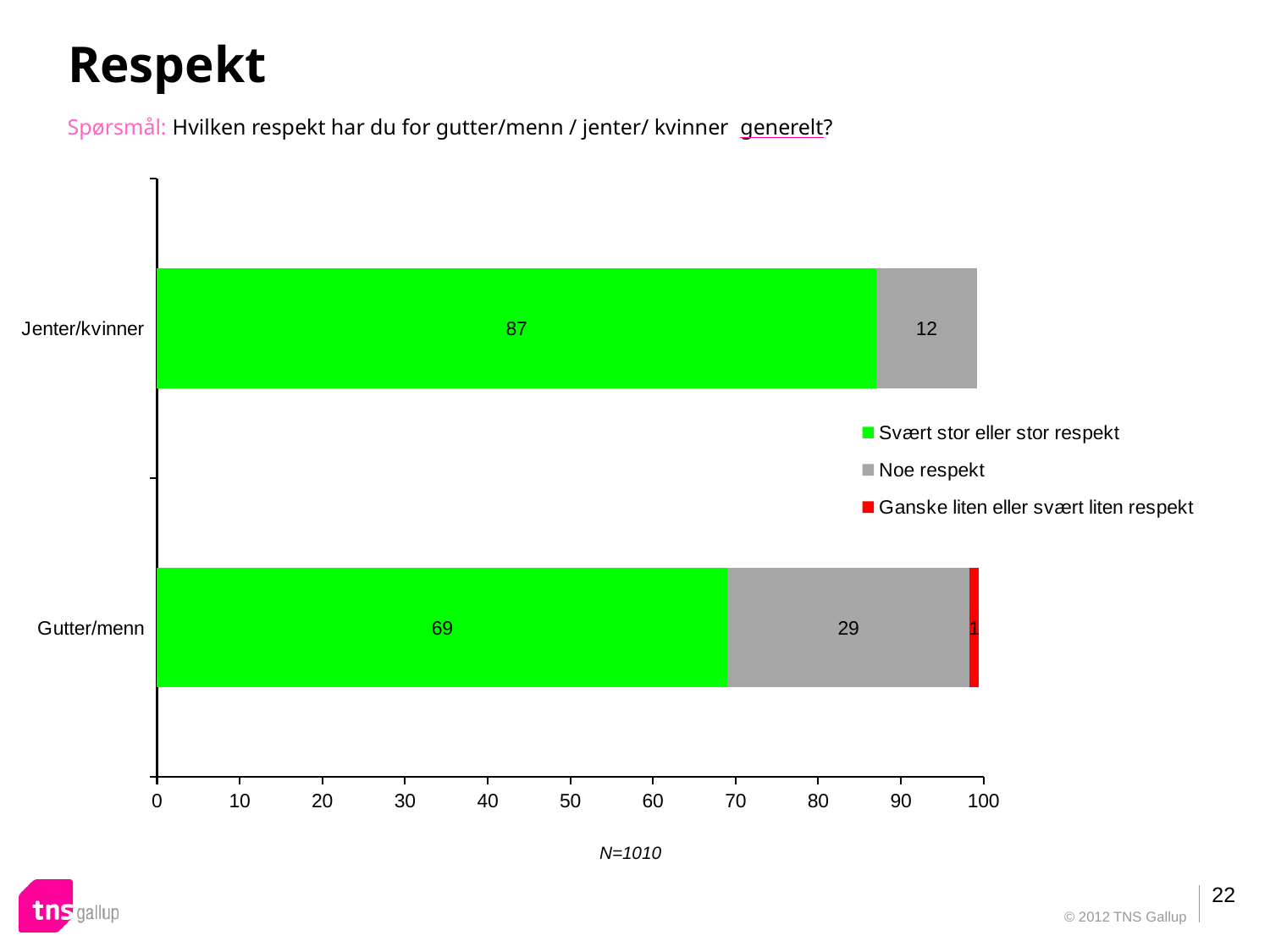
What is the value for "Noe respekt" for Gutter/menn? 29 What is the total of the stacked bar for Gutter/menn? 99 What is the value for "Svært stor eller stor respekt" for Jenter/kvinner? 87 How many series does the legend list? 3 What is the value for "Ganske liten eller svært liten respekt" for Gutter/menn? 1 What is the value for "Noe respekt" for Jenter/kvinner? 12 How many categories are shown on the chart? 2 Which category has the lower value for "Noe respekt"? Jenter/kvinner Is the "Noe respekt" value larger for Gutter/menn or for Jenter/kvinner? Gutter/menn Which category has the higher value for "Svært stor eller stor respekt"? Jenter/kvinner What is the difference between the "Svært stor eller stor respekt" values for Jenter/kvinner and Gutter/menn? 18 What kind of chart is shown on the slide? Stacked bar chart